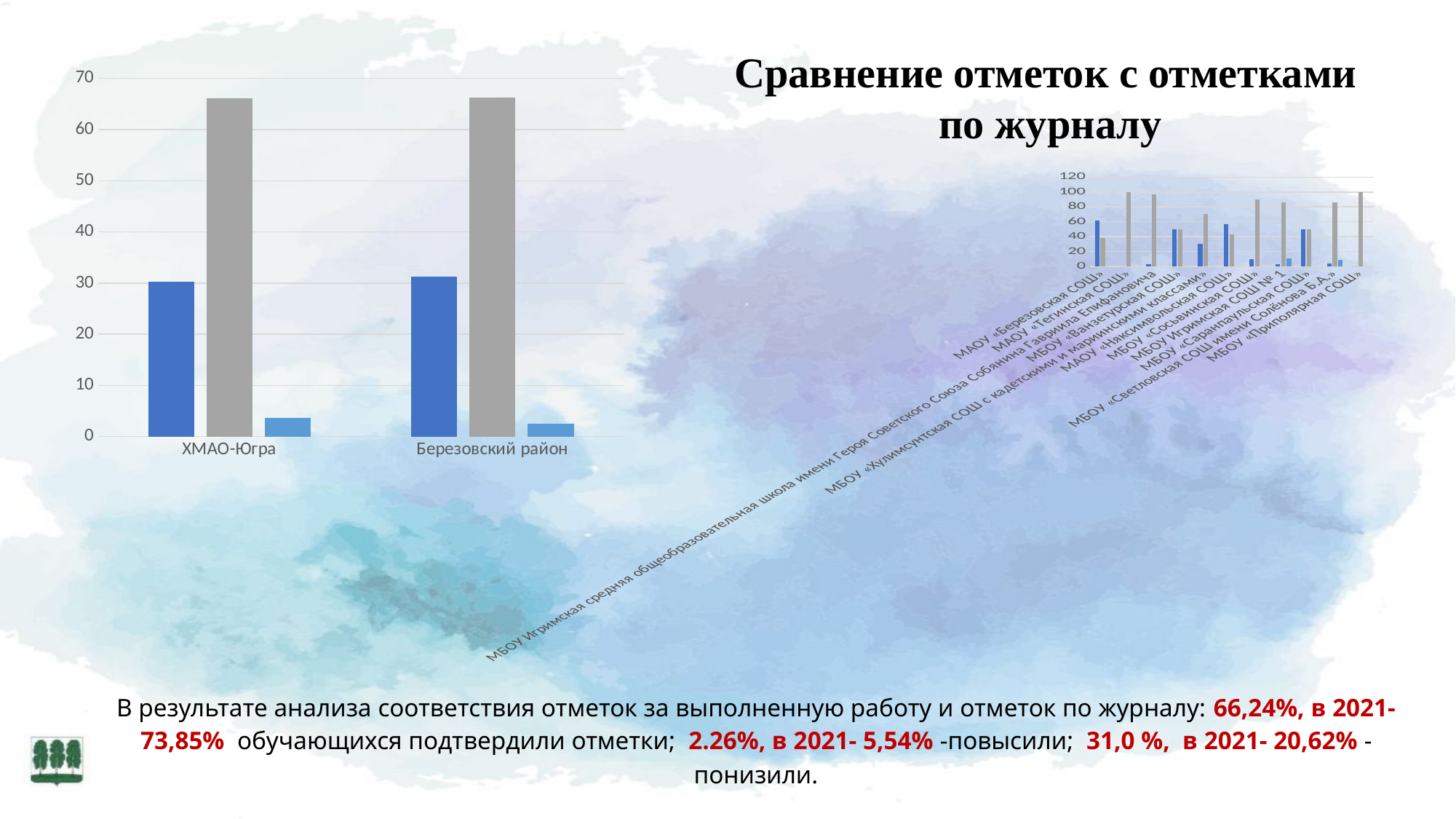
What kind of chart is the chart on the right of the slide? bar chart In the left chart, which bar is the shortest for ХМАО-Югра? the light blue bar What are the two categories on the x axis of the left chart? ХМАО-Югра and Березовский район In the right chart, is the value of the gray bar for МБОУ «Приполярная СОШ» greater or less than 80? greater What kind of chart is the chart on the left of the slide? bar chart In the left chart, which is larger for ХМАО-Югра: the blue bar or the gray bar? the gray bar In the left chart, is the value of the blue bar for Березовский район greater or less than 20? greater In the left chart, which bar is the tallest for Березовский район? the gray bar How many categories are shown on the x axis of the left chart? 2 In the left chart, is the value of the light blue bar for ХМАО-Югра greater or less than 10? less